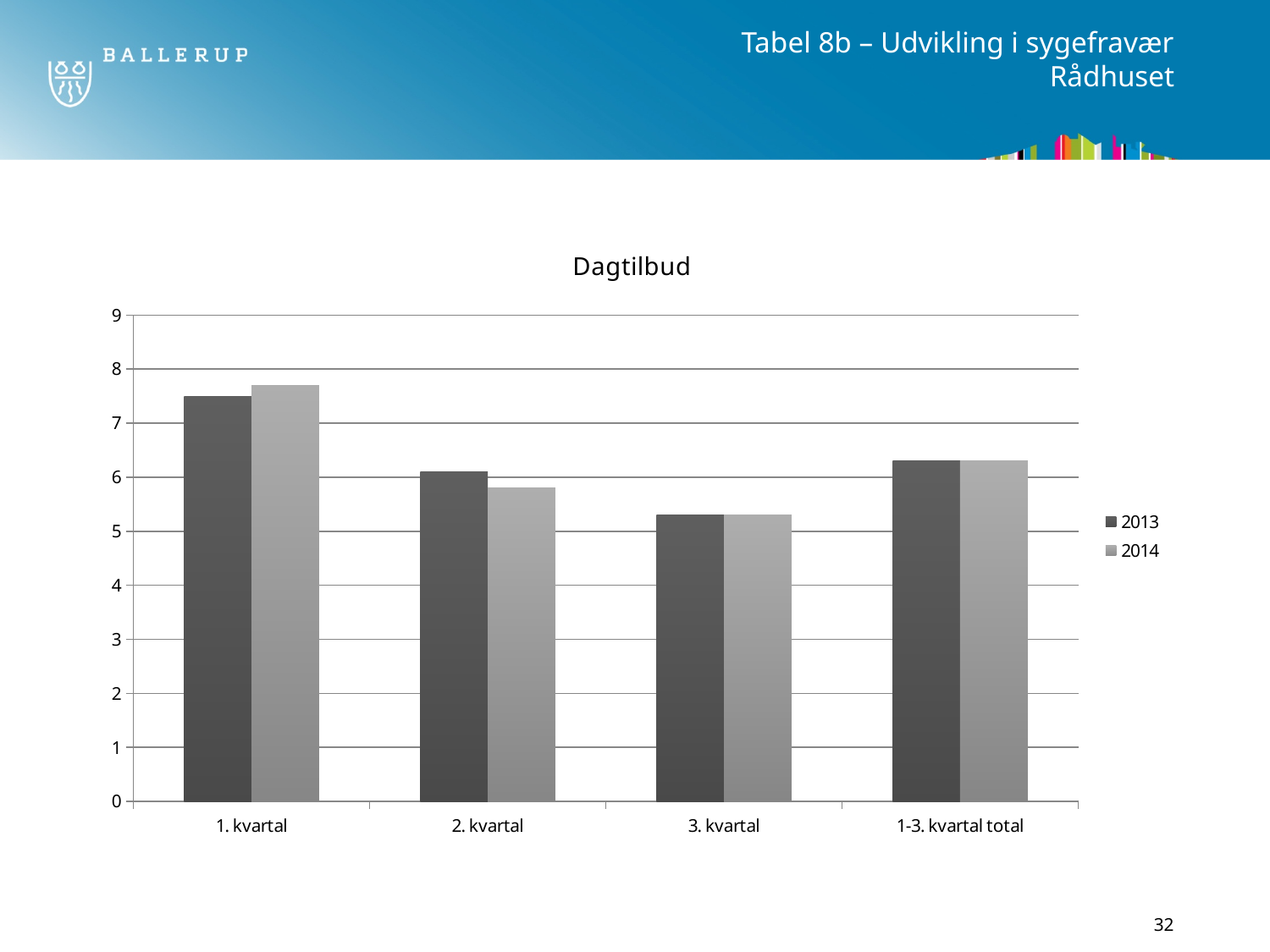
For 2. kvartal, which is larger: the 2013 value or the 2014 value? 2013 What kind of chart is shown on the slide? bar chart Which category has the lowest value for 2014? 3. kvartal What is the title of the chart? Dagtilbud Which category has the highest value for 2013? 1. kvartal Which years are listed in the legend? 2013 and 2014 How many categories are shown on the x axis? 4 For 1. kvartal, which is larger: the 2013 value or the 2014 value? 2014 Do the 2013 values rise or fall from 1. kvartal to 3. kvartal? fall How many series does the legend list? 2 Is the 2014 value for 1. kvartal greater or less than 7? greater Is the 2013 value for 3. kvartal greater or less than 6? less